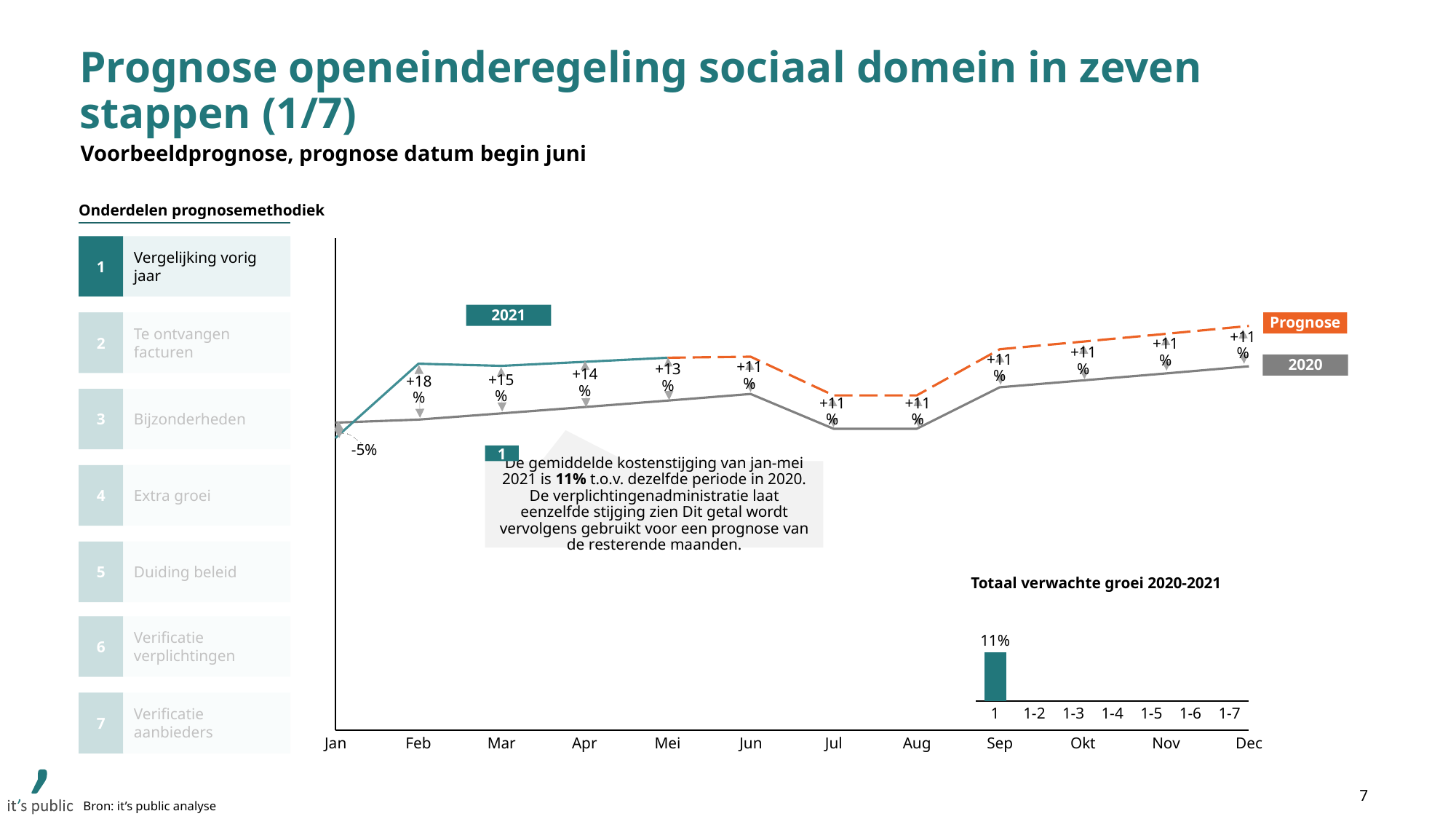
In the line chart, what percentage difference is labelled for Feb? +18% In the line chart, what percentage difference is labelled for Jan? -5% In the line chart, is the labelled percentage for Mar larger or smaller than for Apr? larger In the line chart, which month has the highest labelled percentage difference? Feb In the chart titled 'Totaal verwachte groei 2020-2021', how many categories are listed on the x axis? 7 In the line chart, how many months are shown on the x axis? 12 What kind of chart is 'Totaal verwachte groei 2020-2021'? bar chart In the line chart, which month has the lowest labelled percentage difference? Jan In the chart titled 'Totaal verwachte groei 2020-2021', what is the value of the bar for category 1? 11% In the line chart, what percentage difference is labelled for Mei? +13% In the line chart, how many series are labelled (2021, Prognose, 2020)? 3 In the line chart, what is the difference in percentage points between the Feb label (+18%) and the Mar label (+15%)? 3 percentage points